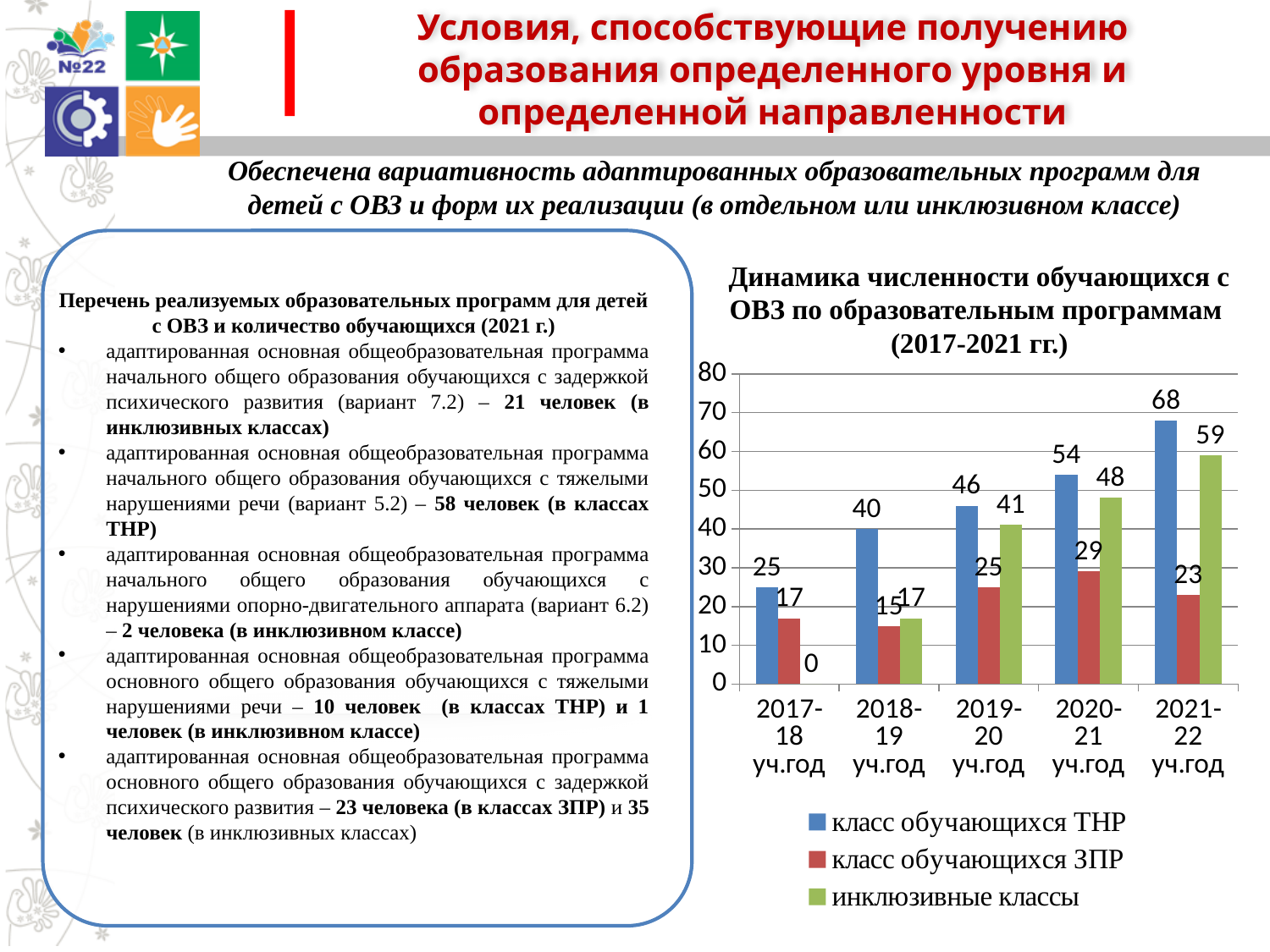
In which academic year is the value for класс обучающихся ТНР the highest? 2021-22 уч.год What is the difference between класс обучающихся ТНР and инклюзивные классы in 2021-22 уч.год? 9 What is the title of the chart? Динамика численности обучающихся с ОВЗ по образовательным программам (2017-2021 гг.) What is the value for класс обучающихся ЗПР in 2020-21 уч.год? 29 What is the value for инклюзивные классы in 2017-18 уч.год? 0 In which academic year is the value for класс обучающихся ЗПР the lowest? 2018-19 уч.год How many academic years are shown on the x axis of the chart? 5 Does the value for класс обучающихся ТНР rise or fall from 2017-18 to 2021-22 уч.год? rise What is the value for класс обучающихся ТНР in 2021-22 уч.год? 68 How many series does the chart legend list? 3 Which is larger in 2019-20 уч.год: класс обучающихся ТНР or инклюзивные классы? класс обучающихся ТНР What type of chart is shown on the slide? bar chart